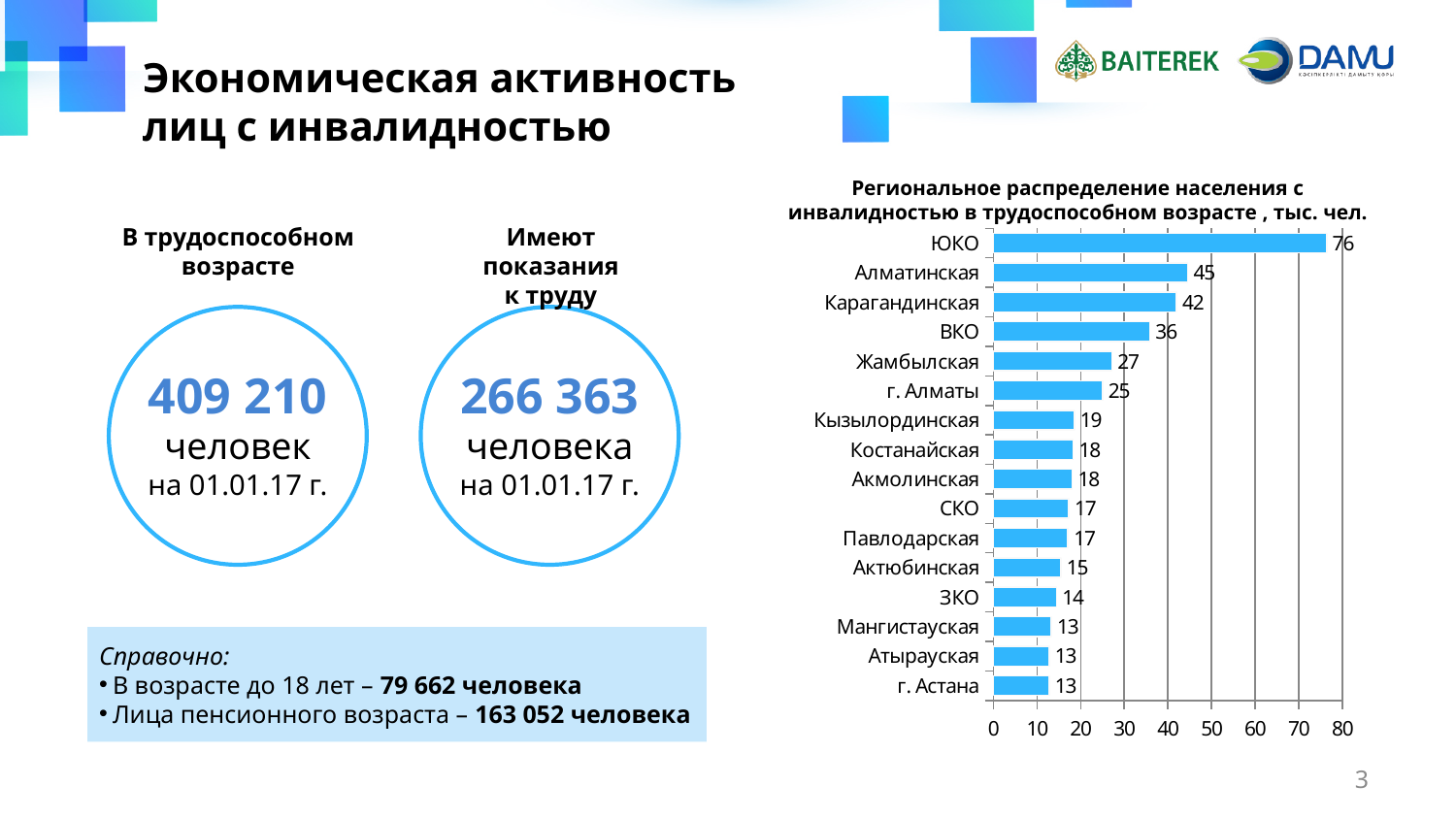
What is the value for ЮКО in the chart? 76 What is the title of the chart? Региональное распределение населения с инвалидностью в трудоспособном возрасте , тыс. чел. What is the value for Алматинская in the chart? 45 Which region has the highest value in the chart? ЮКО What type of chart is shown on the slide? bar chart What is the difference between the values for Карагандинская and ВКО? 6 Which has a larger value, Карагандинская or ВКО? Карагандинская What is the value for г. Астана in the chart? 13 What is the difference between the values for ЮКО and Алматинская? 31 Is the value for ВКО greater or less than 30? greater What is the value for Жамбылская in the chart? 27 How many regions are shown in the chart? 16